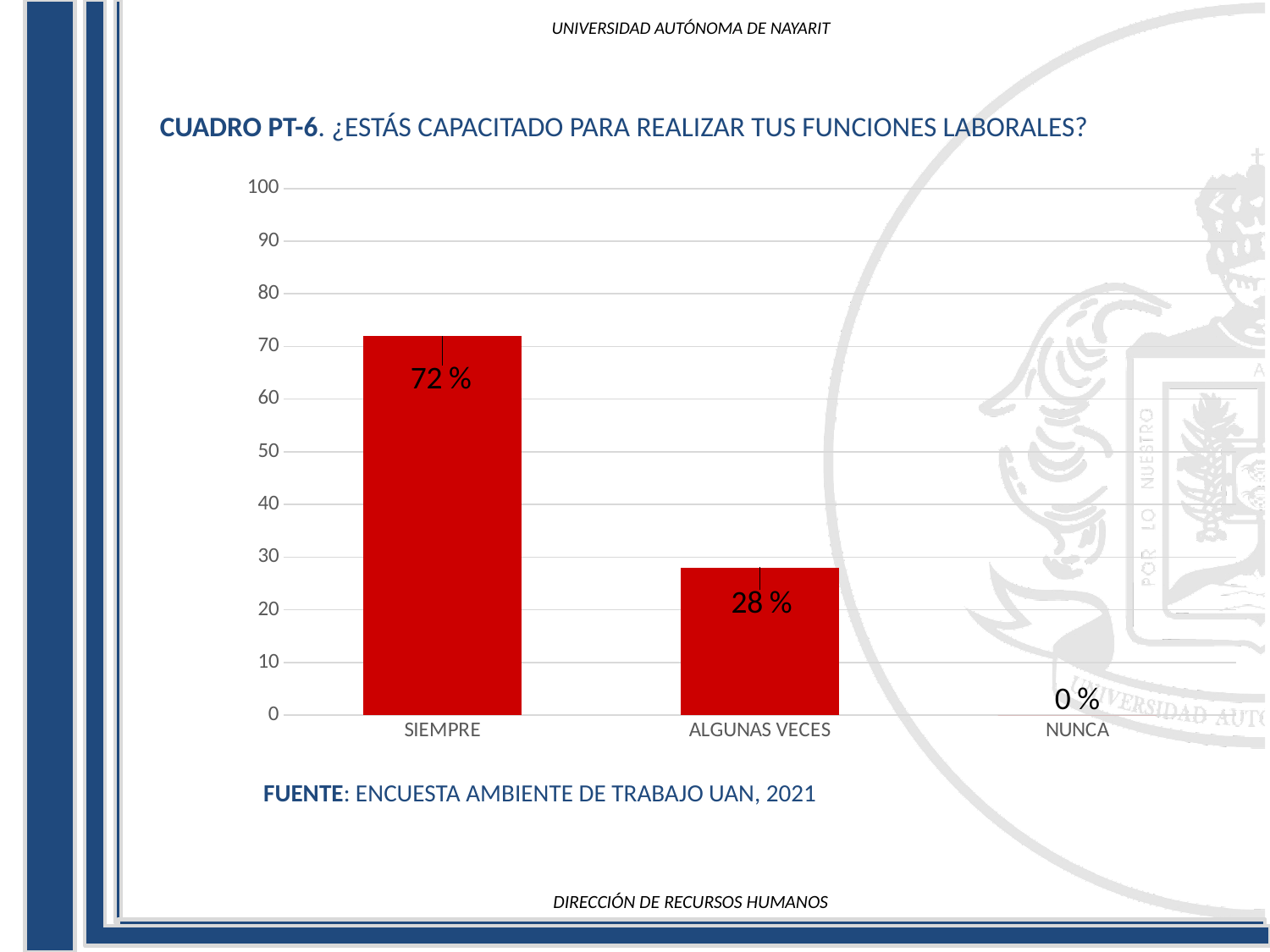
Which category has the highest value? SIEMPRE What is the value for ALGUNAS VECES? 28 % What is the difference between the values for SIEMPRE and ALGUNAS VECES? 44 % What kind of chart is shown on the slide? bar chart Is the value for ALGUNAS VECES greater or less than 40? less How many categories are shown on the x axis? 3 What is the value for NUNCA? 0 % Which category has the lowest value? NUNCA Do the values rise or fall from left to right along the x axis? fall Is the value for SIEMPRE greater or less than 50? greater Which is larger, the value for SIEMPRE or the value for ALGUNAS VECES? SIEMPRE What is the value for SIEMPRE? 72 %